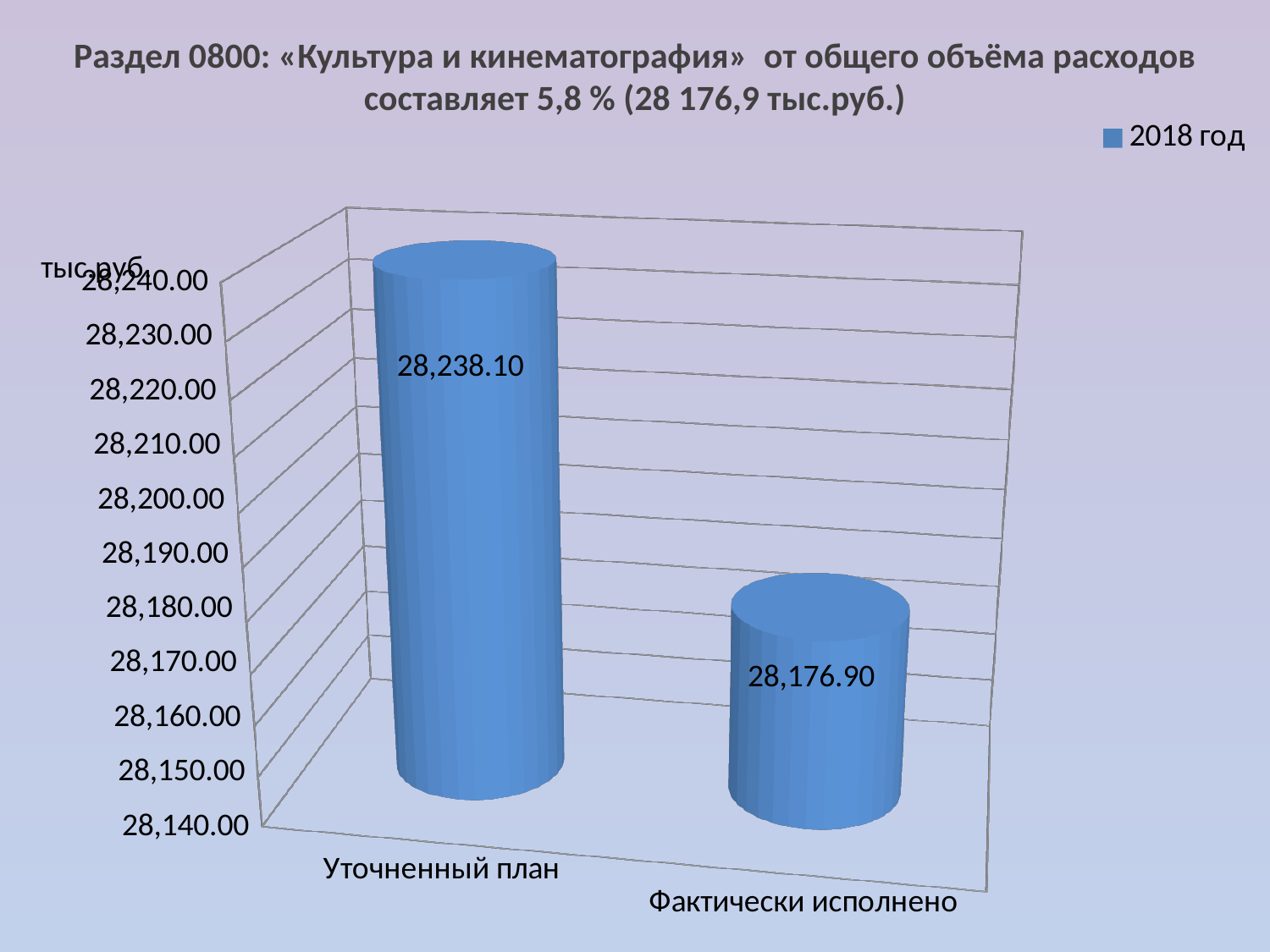
How many categories are shown on the chart? 2 What kind of chart is shown on the slide? bar chart What is the difference between the values for "Уточненный план" and "Фактически исполнено"? 61.20 What series name is shown in the chart legend? 2018 год Is the value for "Уточненный план" greater or less than 28,220.00? greater What is the value for "Уточненный план"? 28,238.10 Is the value for "Фактически исполнено" greater or less than 28,200.00? less Which is larger: the value for "Уточненный план" or the value for "Фактически исполнено"? Уточненный план Which category has the lowest value? Фактически исполнено How many series does the legend list? 1 What is the value for "Фактически исполнено"? 28,176.90 Which category has the highest value? Уточненный план